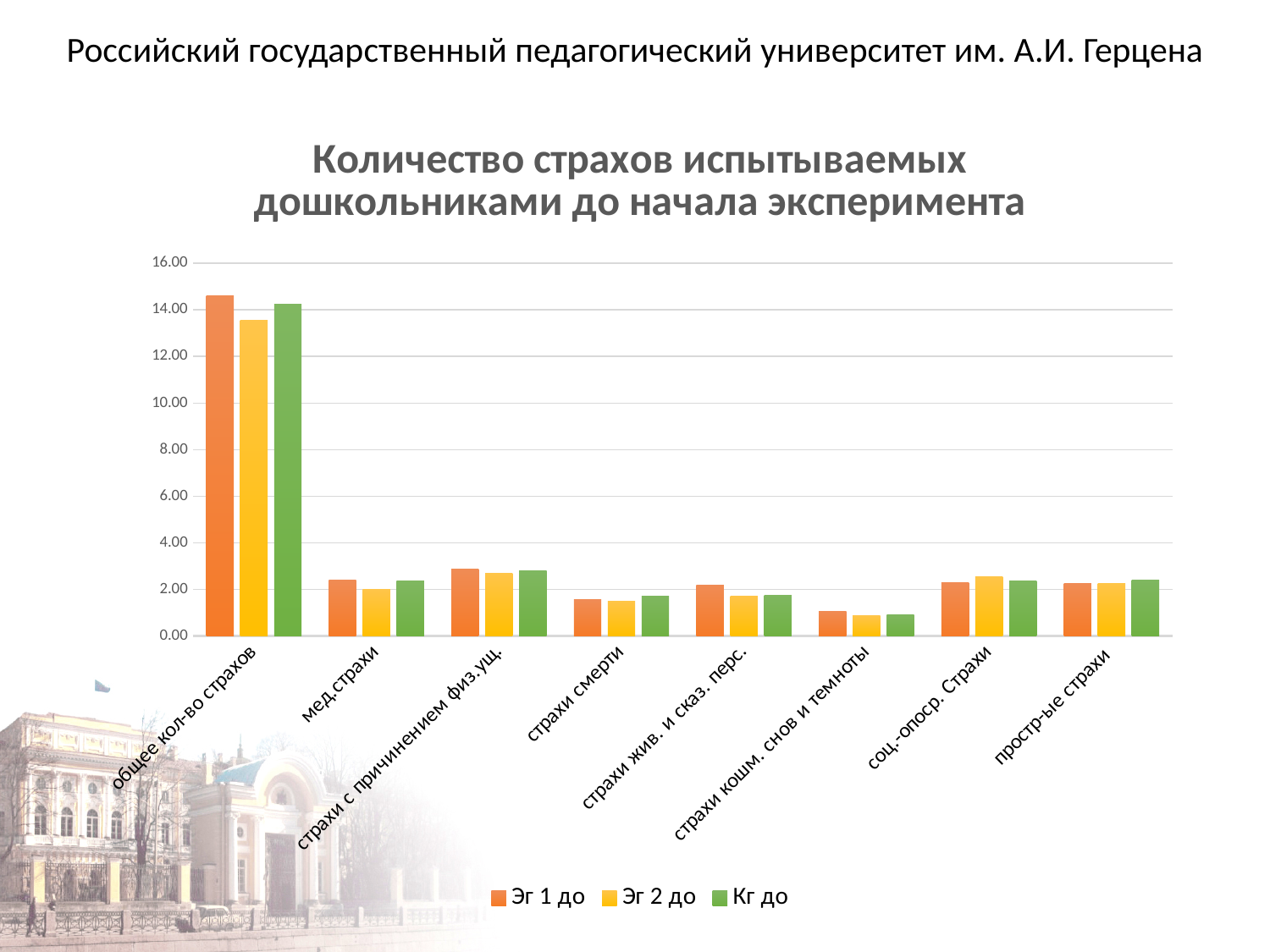
Which category has the lowest value for the series Эг 2 до? страхи кошм. снов и темноты Which category has the highest value for the series Эг 1 до? общее кол-во страхов How many categories are shown along the x axis of the chart? 8 What is the title of the chart? Количество страхов испытываемых дошкольниками до начала эксперимента Is the value for общее кол-во страхов in the series Эг 1 до greater or less than 14.00? greater Is the value for общее кол-во страхов in the series Эг 2 до greater or less than 14.00? less What kind of chart is shown on the slide? bar chart Which category has the lowest value for the series Эг 1 до? страхи кошм. снов и темноты For мед.страхи, which series has the larger value: Эг 1 до or Эг 2 до? Эг 1 до Is the value for страхи кошм. снов и темноты in the series Кг до greater or less than 2.00? less For общее кол-во страхов, which series has the larger value: Эг 1 до or Эг 2 до? Эг 1 до How many series does the chart's legend list? 3